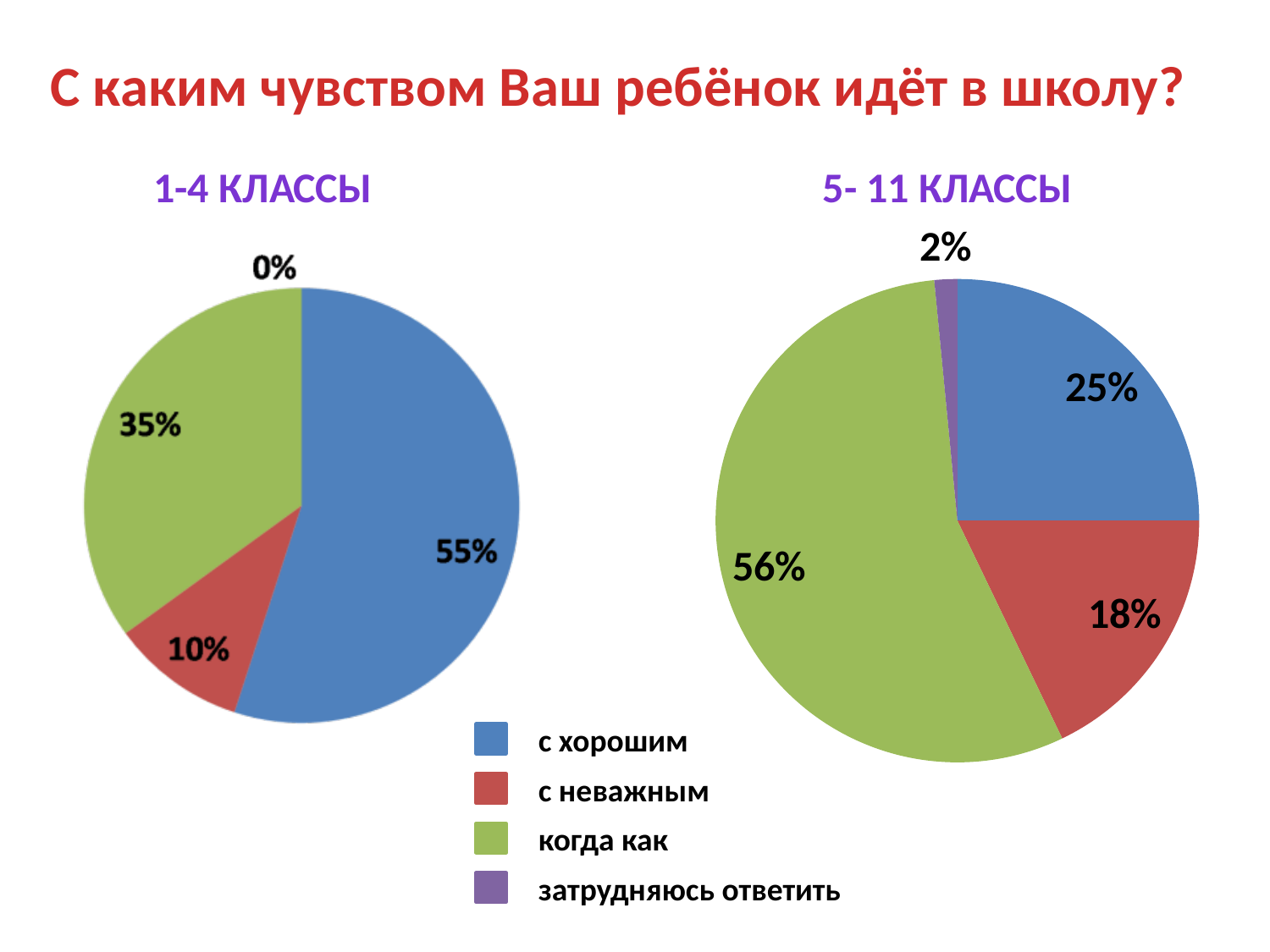
In the "5- 11 КЛАССЫ" chart, what share is labelled for "затрудняюсь ответить"? 2% In the "1-4 КЛАССЫ" chart, what share is labelled for "с хорошим"? 55% In the "1-4 КЛАССЫ" chart, what share is labelled for "когда как"? 35% In the "5- 11 КЛАССЫ" chart, which category has the smallest slice? затрудняюсь ответить In the "5- 11 КЛАССЫ" chart, what is the difference between the shares for "с хорошим" and "с неважным"? 7% In the "1-4 КЛАССЫ" chart, which category has the largest slice? с хорошим How many entries does the legend list? 4 In the "1-4 КЛАССЫ" chart, which is larger: the share for "с хорошим" or the share for "когда как"? с хорошим In the "5- 11 КЛАССЫ" chart, what share is labelled for "когда как"? 56% In the "5- 11 КЛАССЫ" chart, which category has the largest slice? когда как In the "1-4 КЛАССЫ" chart, what share is labelled for "с неважным"? 10% What type of chart is used on this slide? Pie chart